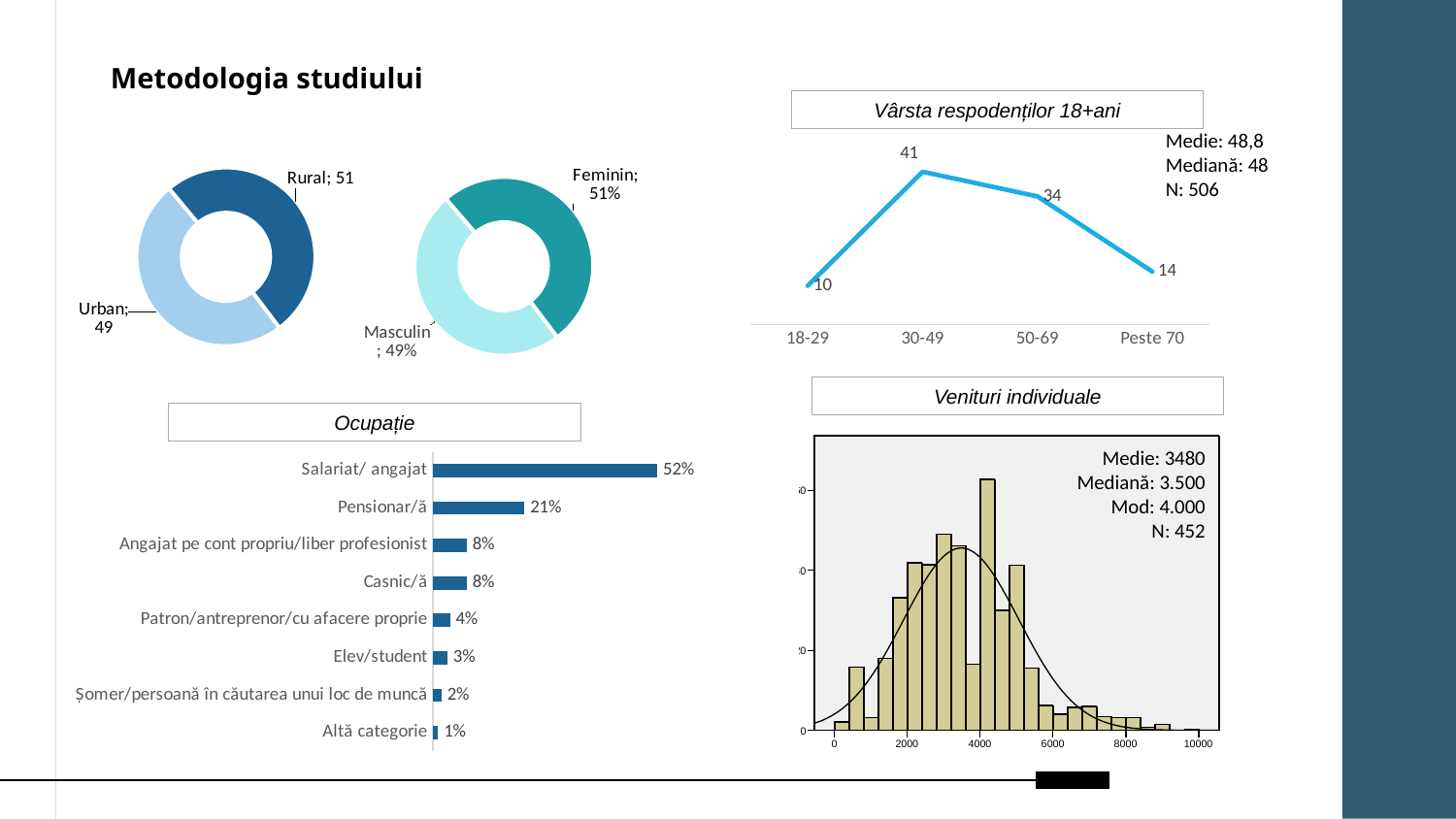
In the Ocupație bar chart, how many categories are shown? 8 What is the title of the chart in the lower right of the slide? Venituri individuale In the Vârsta respondenților 18+ani line chart, which age group has the lowest value? 18-29 In the Rural/Urban donut chart, what is the value for Rural? 51 What kind of chart is the Ocupație chart? bar chart In the Ocupație bar chart, what is the value for Salariat/ angajat? 52% In the Ocupație bar chart, what is the difference between Salariat/ angajat and Pensionar/ă? 31% In the Ocupație bar chart, which category has the lowest value? Altă categorie In the Ocupație bar chart, what is the value for Pensionar/ă? 21% In the Feminin/Masculin donut chart, which is larger, Feminin or Masculin? Feminin In the Vârsta respondenților 18+ani line chart, what is the value for 30-49? 41 In the Vârsta respondenților 18+ani line chart, what is the difference between 50-69 and Peste 70? 20